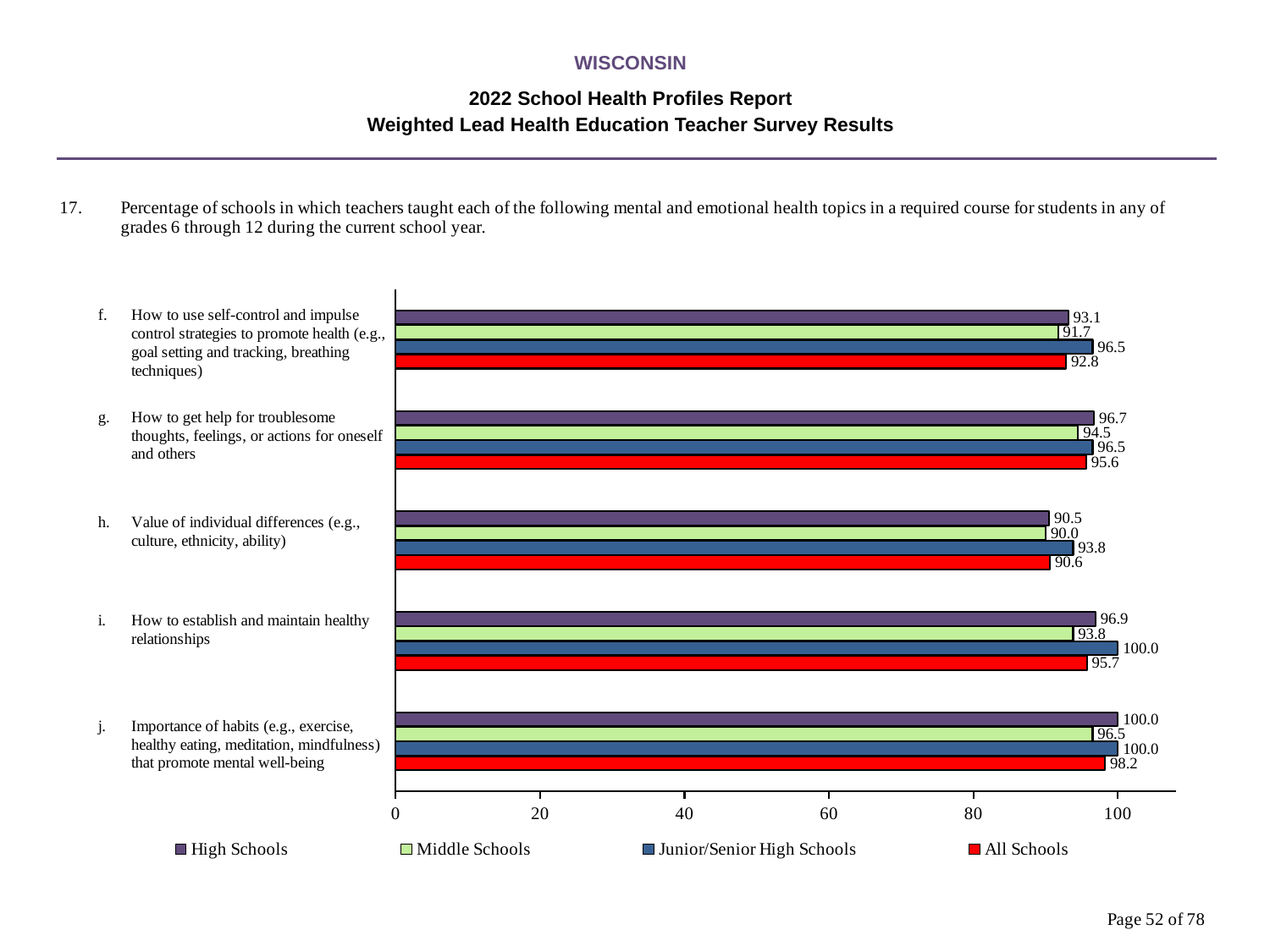
What is the value for Middle Schools for topic h (Value of individual differences)? 90.0 What is the value for Junior/Senior High Schools for topic i (How to establish and maintain healthy relationships)? 100.0 What is the value for High Schools for topic f (How to use self-control and impulse control strategies to promote health)? 93.1 What is the value for All Schools for topic j (Importance of habits that promote mental well-being)? 98.2 What is the difference between the Junior/Senior High Schools value and the Middle Schools value for topic i (healthy relationships)? 6.2 Which topic has the lowest value for Middle Schools? h. Value of individual differences (e.g., culture, ethnicity, ability) Which series is shown in red in the legend? All Schools How many series does the legend list? 4 How many topics (categories) are shown on the chart? 5 Which topic has the highest value for All Schools? j. Importance of habits (e.g., exercise, healthy eating, meditation, mindfulness) that promote mental well-being What kind of chart is shown on the slide? Bar chart For topic g (How to get help for troublesome thoughts, feelings, or actions), which is larger: the High Schools value or the Middle Schools value? High Schools